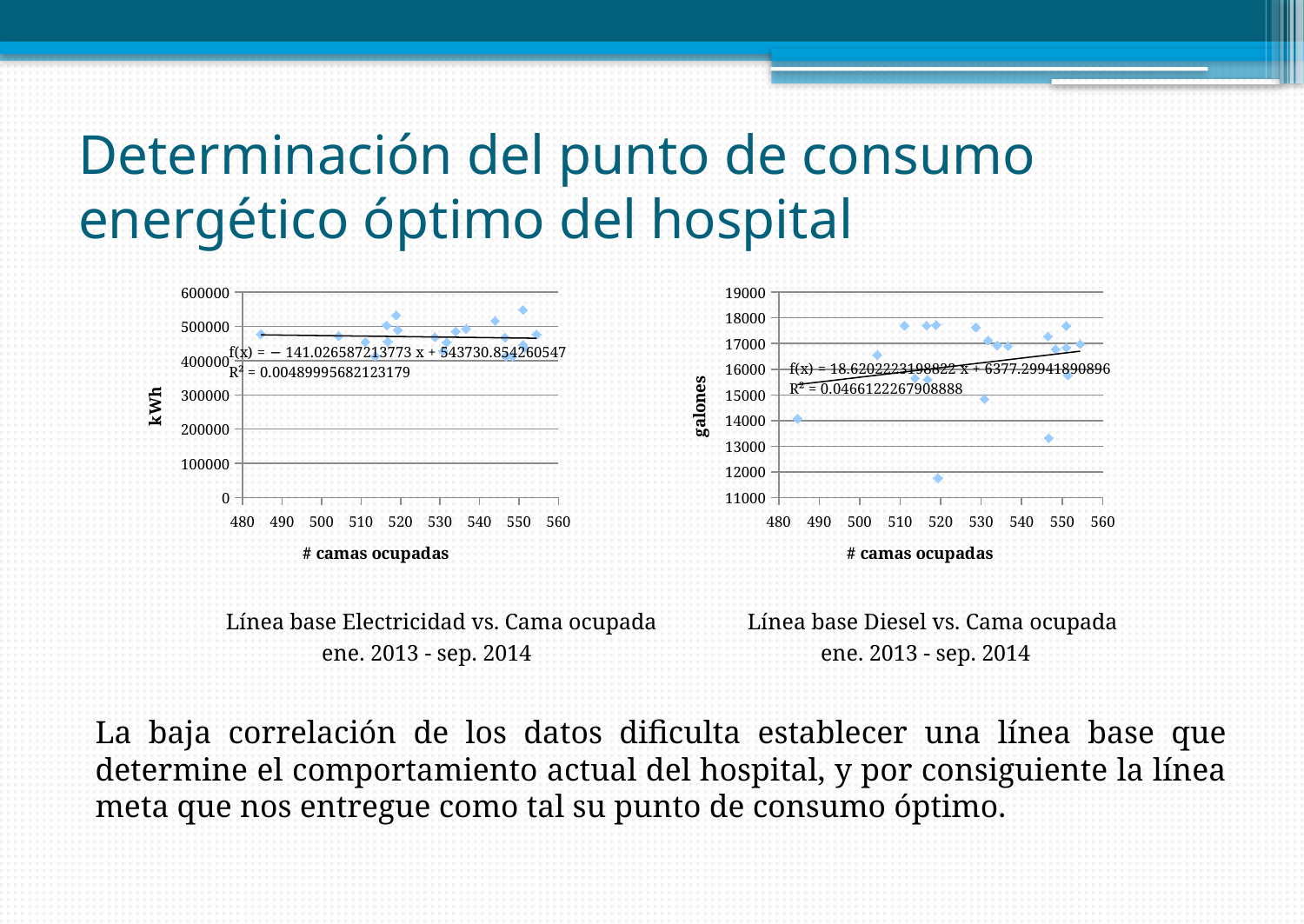
In the right chart (Línea base Diesel vs. Cama ocupada), what R² value is printed for the trendline? 0.0466122267908888 In the right chart (Línea base Diesel vs. Cama ocupada), does the trendline rise or fall as the number of occupied beds increases? rise In the left chart (Línea base Electricidad vs. Cama ocupada), is the value of the highest point greater or less than 500000 kWh? greater In the left chart (Línea base Electricidad vs. Cama ocupada), what is the y-axis title? kWh In the left chart (Línea base Electricidad vs. Cama ocupada), what is the intercept of the printed trendline equation f(x)? 543730.854260547 In the right chart (Línea base Diesel vs. Cama ocupada), what is the y-axis title? galones In the right chart (Línea base Diesel vs. Cama ocupada), what is the slope of the printed trendline equation f(x)? 18.6202223198822 In the left chart (Línea base Electricidad vs. Cama ocupada), what R² value is printed for the trendline? 0.00489995682123179 In the left chart (Línea base Electricidad vs. Cama ocupada), does the trendline rise or fall as the number of occupied beds increases? fall What kind of chart is the right chart (Línea base Diesel vs. Cama ocupada)? scatter chart What kind of chart is the left chart (Línea base Electricidad vs. Cama ocupada)? scatter chart In the right chart (Línea base Diesel vs. Cama ocupada), is the value of the lowest point greater or less than 13000 galones? less